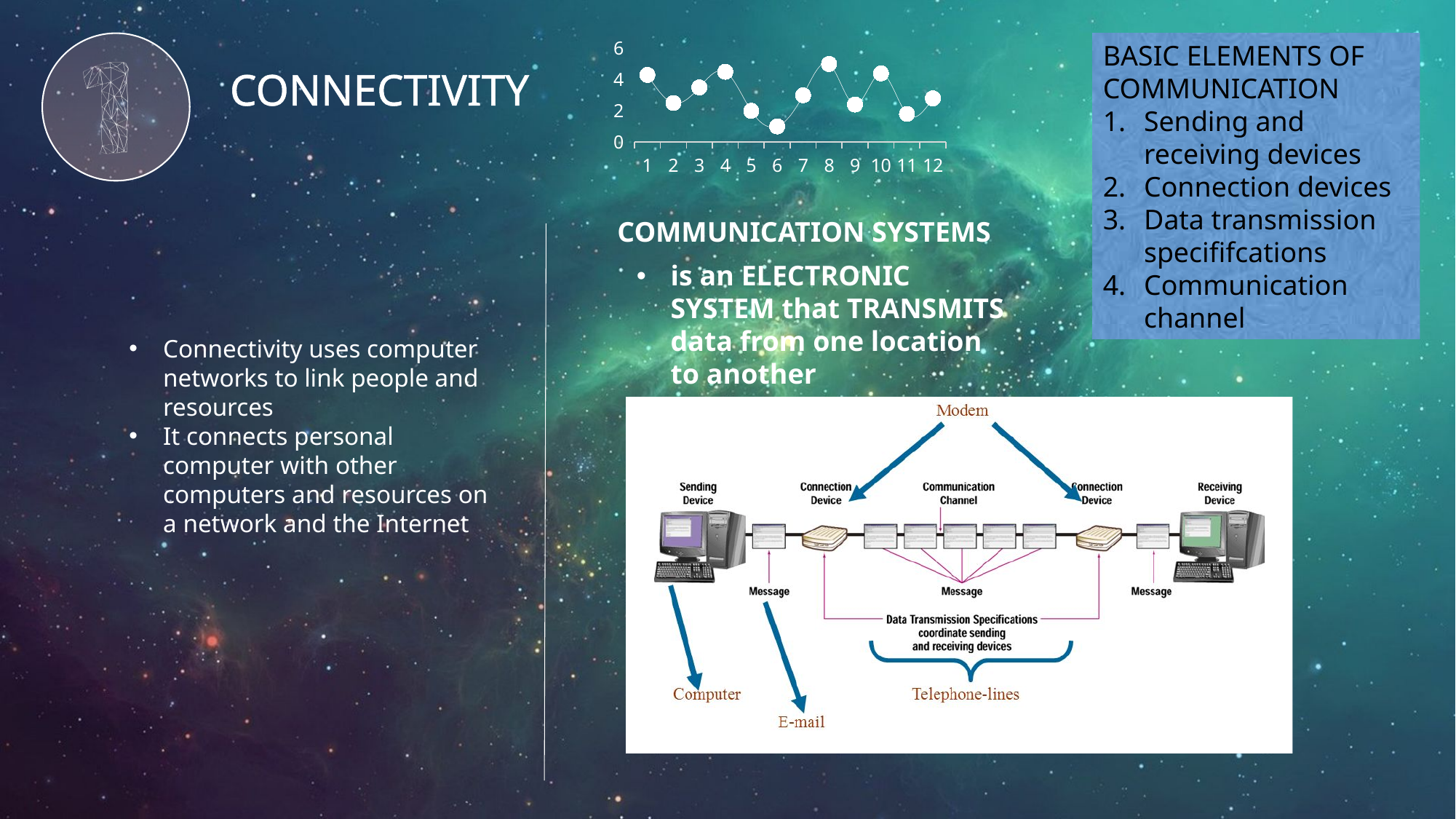
What is the highest tick value shown on the y-axis of the line chart? 6 At which x-axis category does the line chart reach its lowest value? 6 At which x-axis category does the line chart reach its highest value? 8 On the line chart, which has the larger value: category 8 or category 9? 8 Is the value at category 7 on the line chart greater or less than 2? greater Is the value at category 6 on the line chart greater or less than 2? less What kind of chart is shown at the top of the slide? line chart On the line chart, which has the larger value: category 4 or category 5? 4 Does the line chart rise or fall from category 5 to category 6? fall Is the value at category 9 on the line chart greater or less than 4? less How many data points are plotted on the line chart? 12